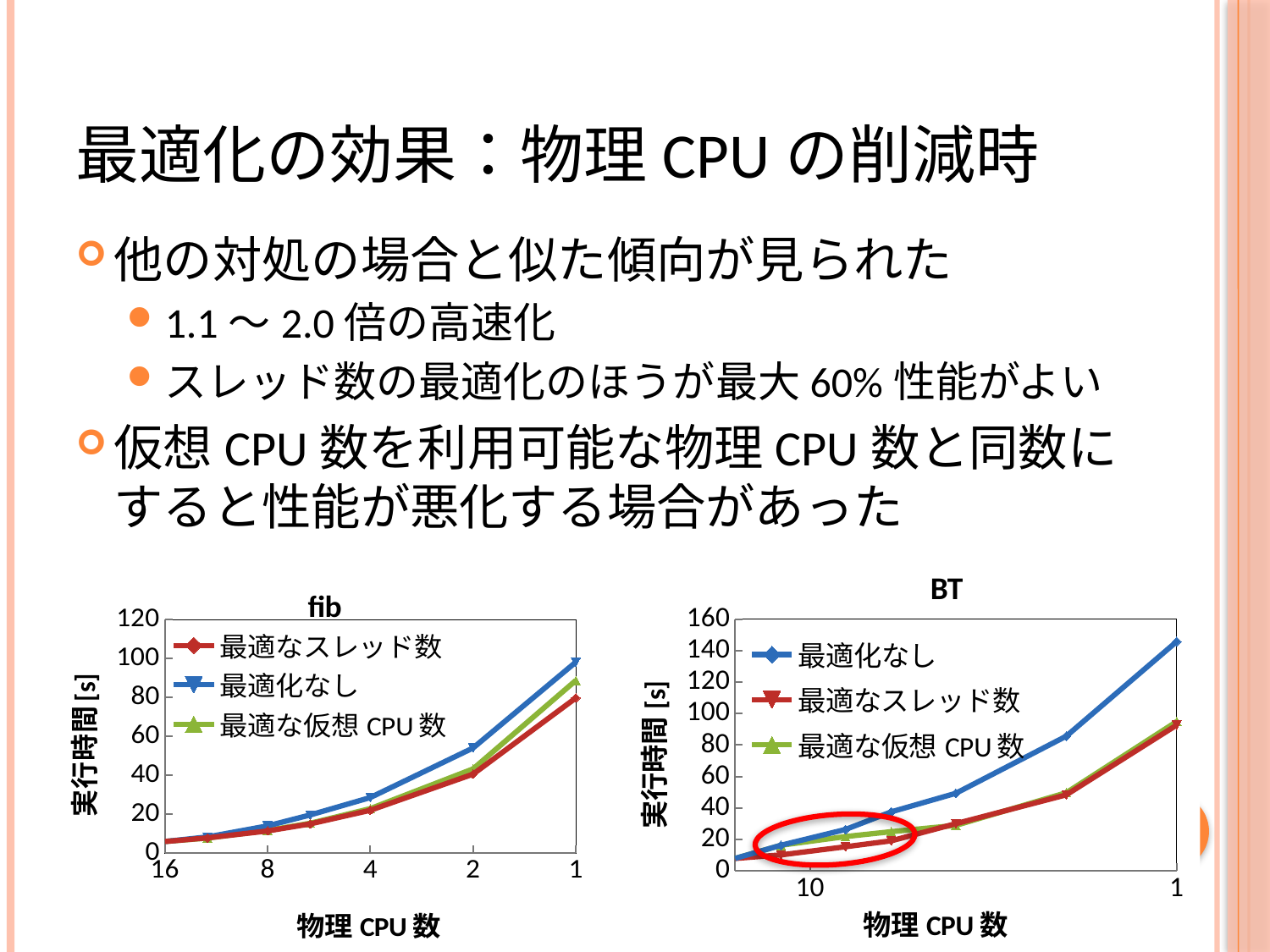
In the BT chart, is the value of 最適なスレッド数 at 1 physical CPU greater or less than 120? less What is the y-axis label of the BT chart? 実行時間 [s] How many series does the legend of the fib chart list? 3 What kind of chart is the chart titled fib? line chart In the fib chart, is the value of 最適なスレッド数 at 1 physical CPU greater or less than 100? less In the fib chart, is the value of 最適化なし at 1 physical CPU greater or less than 80? greater In the fib chart, at 1 physical CPU, which series has the larger value: 最適化なし or 最適なスレッド数? 最適化なし In the BT chart, which series has the highest value at 1 physical CPU? 最適化なし What is the x-axis label of the fib chart? 物理 CPU 数 In the fib chart, do the values rise or fall along the x axis from left (16) to right (1)? rise How many series does the legend of the BT chart list? 3